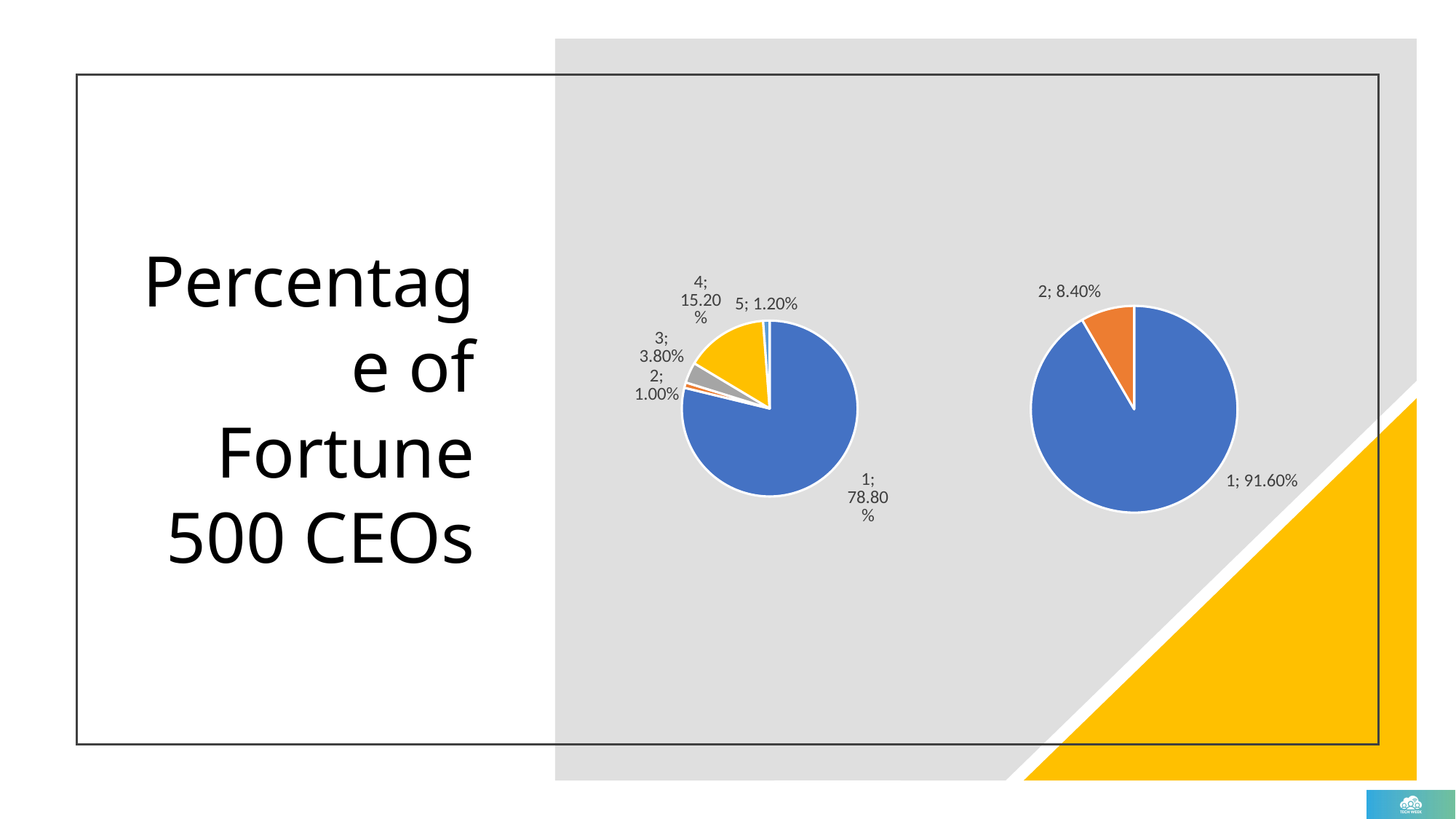
In the left pie chart, what is the value for category 4? 15.20% In the left pie chart, what is the value for category 1? 78.80% In the left pie chart, which category has the smallest slice? 2 How many slices does the right pie chart have? 2 In the left pie chart, what is the difference between the values for category 4 and category 3? 11.40% What kind of chart is the left chart on the slide? Pie chart In the left pie chart, which category has the largest slice? 1 Which is larger: category 1 in the left pie chart or category 1 in the right pie chart? Category 1 in the right pie chart In the right pie chart, what is the value for category 2? 8.40% In the right pie chart, what is the value for category 1? 91.60% How many slices does the left pie chart have? 5 In the left pie chart, what is the value for category 3? 3.80%